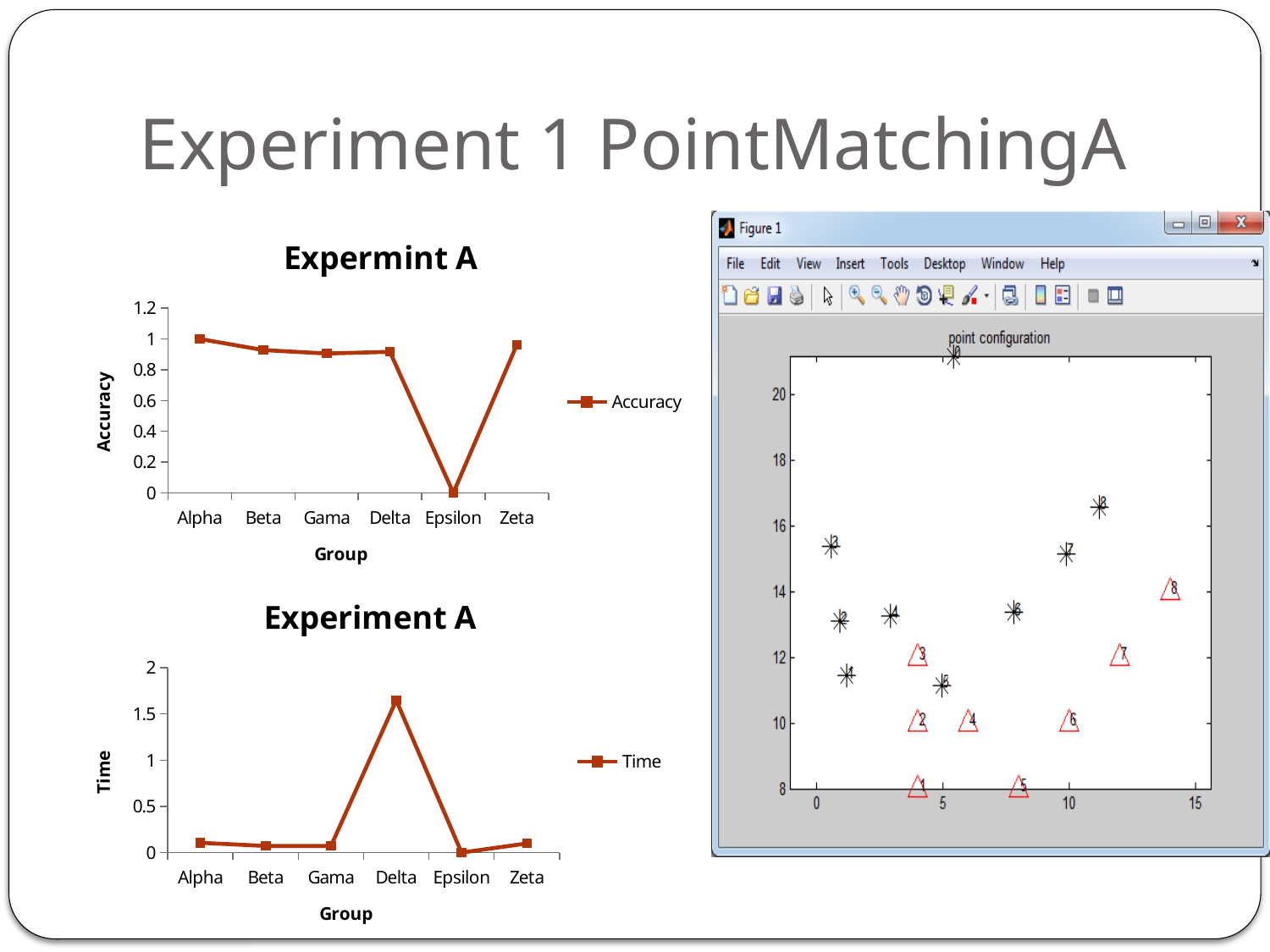
In the 'Expermint A' accuracy chart, is the accuracy for Delta greater or less than 0.8? greater What is the x-axis title of the 'Experiment A' time chart? Group In the 'Experiment A' time chart, which group has the highest time? Delta How many series does the legend of the 'Expermint A' accuracy chart list? 1 In the 'Expermint A' accuracy chart, which group has the lowest accuracy? Epsilon In the 'Experiment A' time chart, which has the larger time, Alpha or Delta? Delta What kind of chart is the 'Expermint A' accuracy chart? line chart In the 'Expermint A' accuracy chart, what is the accuracy for Epsilon? 0 How many groups are plotted on the x axis of the 'Expermint A' accuracy chart? 6 In the 'Expermint A' accuracy chart, which has the higher accuracy, Beta or Epsilon? Beta In the 'Experiment A' time chart, is the time for Gama greater or less than 0.5? less In the 'Experiment A' time chart, is the time for Delta greater or less than 1.5? greater